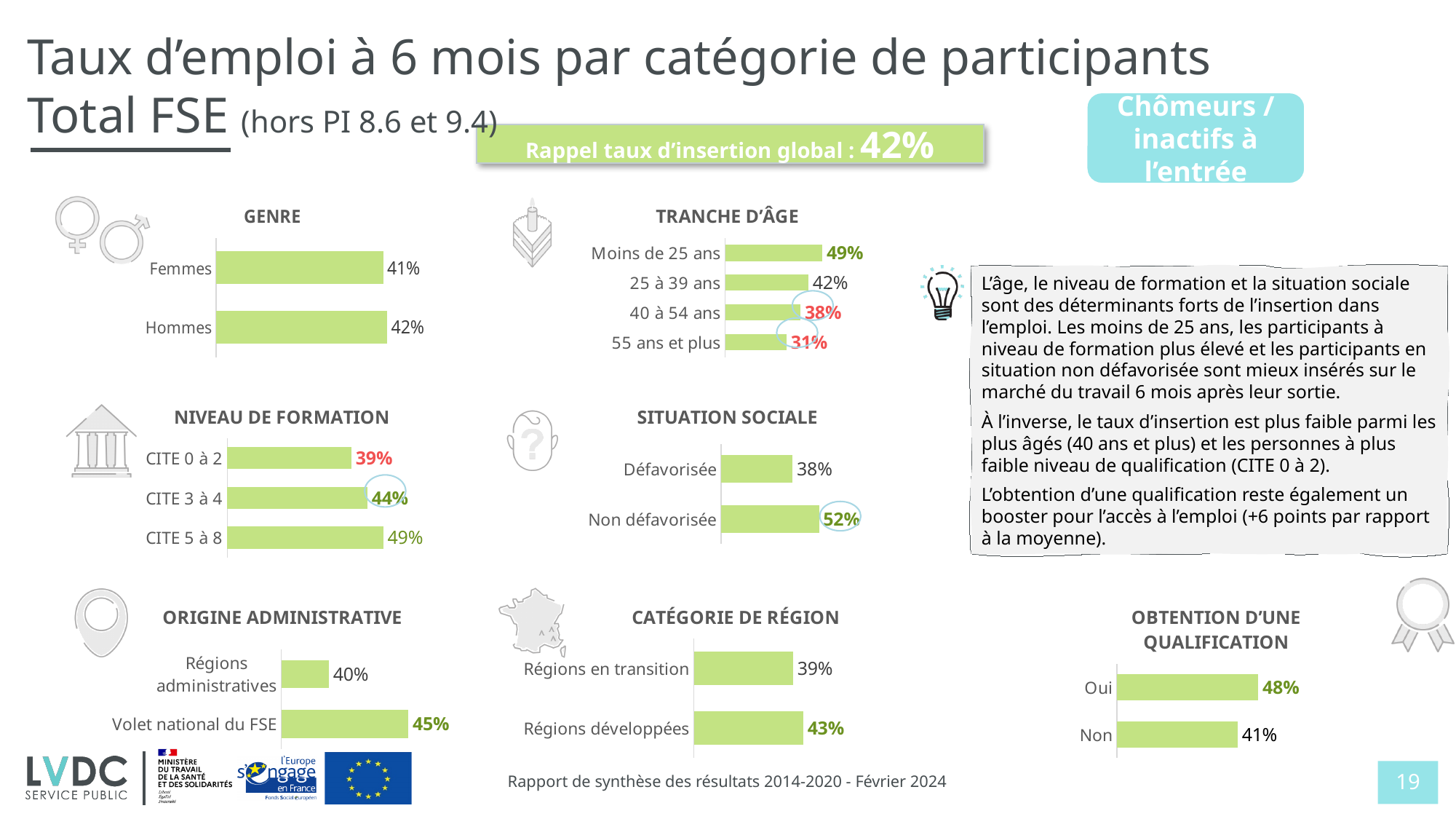
In the GENRE chart, what is the value for Hommes? 42% In the SITUATION SOCIALE chart, what is the difference between Non défavorisée and Défavorisée? 14 points In the CATÉGORIE DE RÉGION chart, what is the value for Régions en transition? 39% In the ORIGINE ADMINISTRATIVE chart, what is the value for Volet national du FSE? 45% What type of chart is used for the TRANCHE D'ÂGE data? Bar chart In the TRANCHE D'ÂGE chart, which age group has the lowest value? 55 ans et plus In the NIVEAU DE FORMATION chart, what is the value for CITE 3 à 4? 44% In the TRANCHE D'ÂGE chart, which age group has the highest value? Moins de 25 ans In the OBTENTION D'UNE QUALIFICATION chart, what is the difference between Oui and Non? 7 points In the SITUATION SOCIALE chart, which is larger, Défavorisée or Non défavorisée? Non défavorisée In the NIVEAU DE FORMATION chart, how many categories are shown? 3 In the TRANCHE D'ÂGE chart, what is the difference between Moins de 25 ans and 55 ans et plus? 18 points